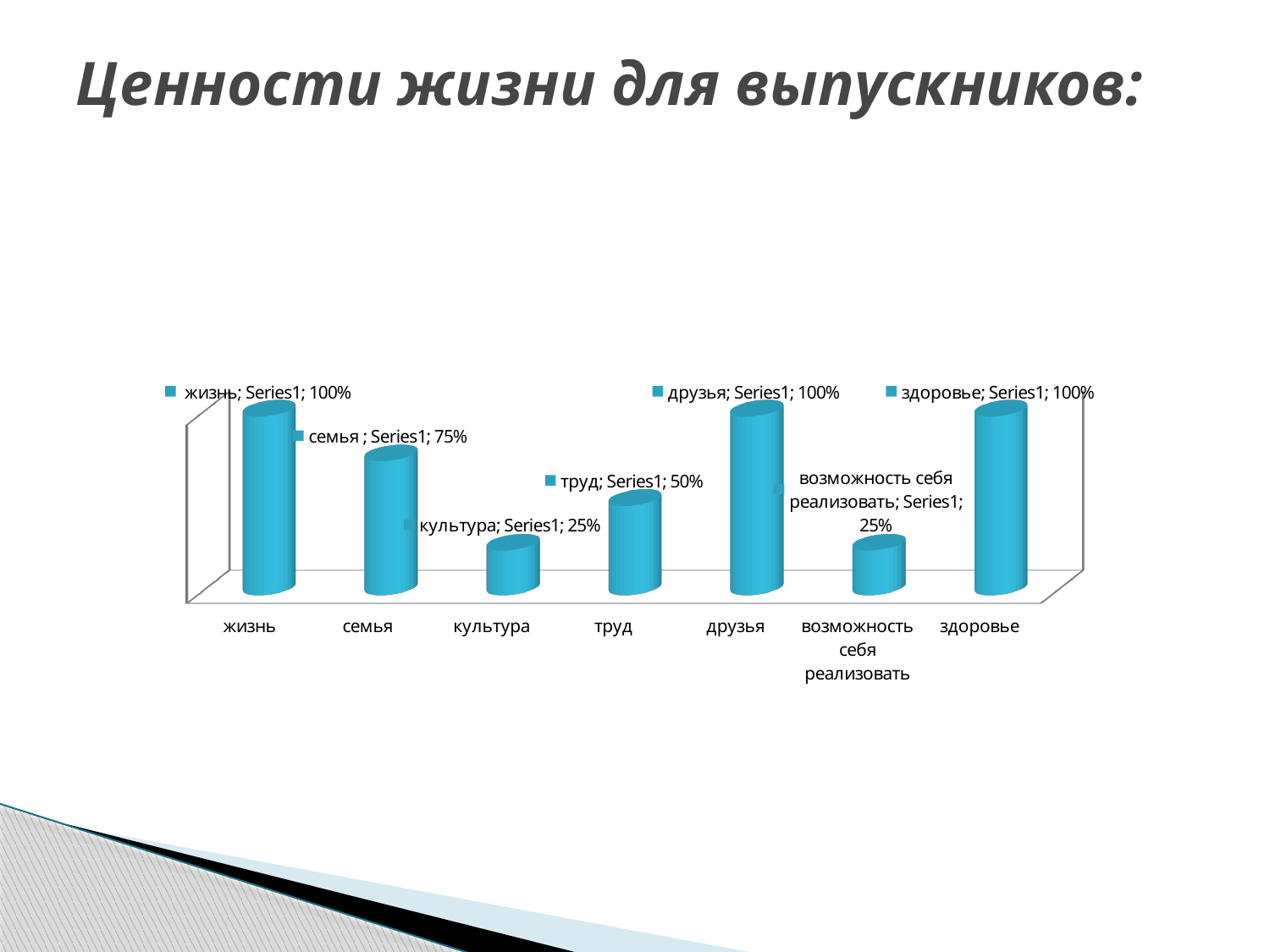
What is the value for возможность себя реализовать? 25% Which is larger, the value for друзья or the value for возможность себя реализовать? друзья Which is larger, the value for семья or the value for труд? семья What is the value for здоровье? 100% How many categories are shown in the chart? 7 What is the value for культура? 25% What is the value for жизнь? 100% What is the difference between the values for семья and труд? 25% What kind of chart is shown on the slide? bar chart What is the value for семья? 75% What is the value for труд? 50% What is the difference between the values for жизнь and культура? 75%